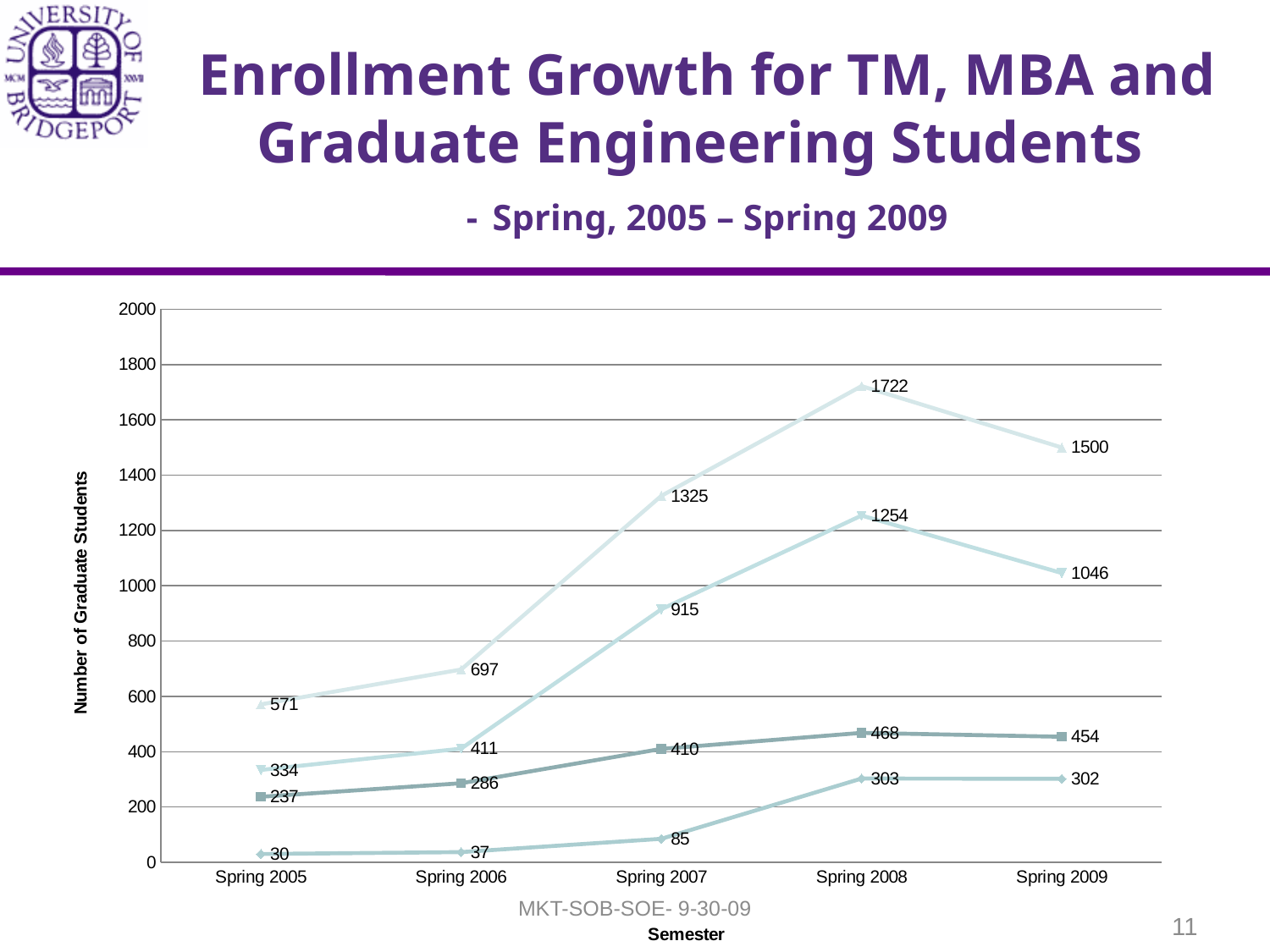
At which semester does the topmost line reach its highest value? Spring 2008 What is the value of the topmost line at Spring 2008? 1722 What is the value of the lowest line at Spring 2005? 30 What kind of chart is shown on the slide? line chart At which semester is the lowest line at its minimum? Spring 2005 What is the value of the topmost line at Spring 2009? 1500 What is the label of the x axis? Semester What is the difference between the topmost line's values at Spring 2008 and Spring 2009? 222 Does the topmost line rise or fall from Spring 2005 to Spring 2008? rise Which is larger: the topmost line's value at Spring 2007 or the second-highest line's value at Spring 2008? Spring 2007 value of the topmost line (1325) What is the label of the y axis? Number of Graduate Students How many semesters are plotted along the x axis? 5